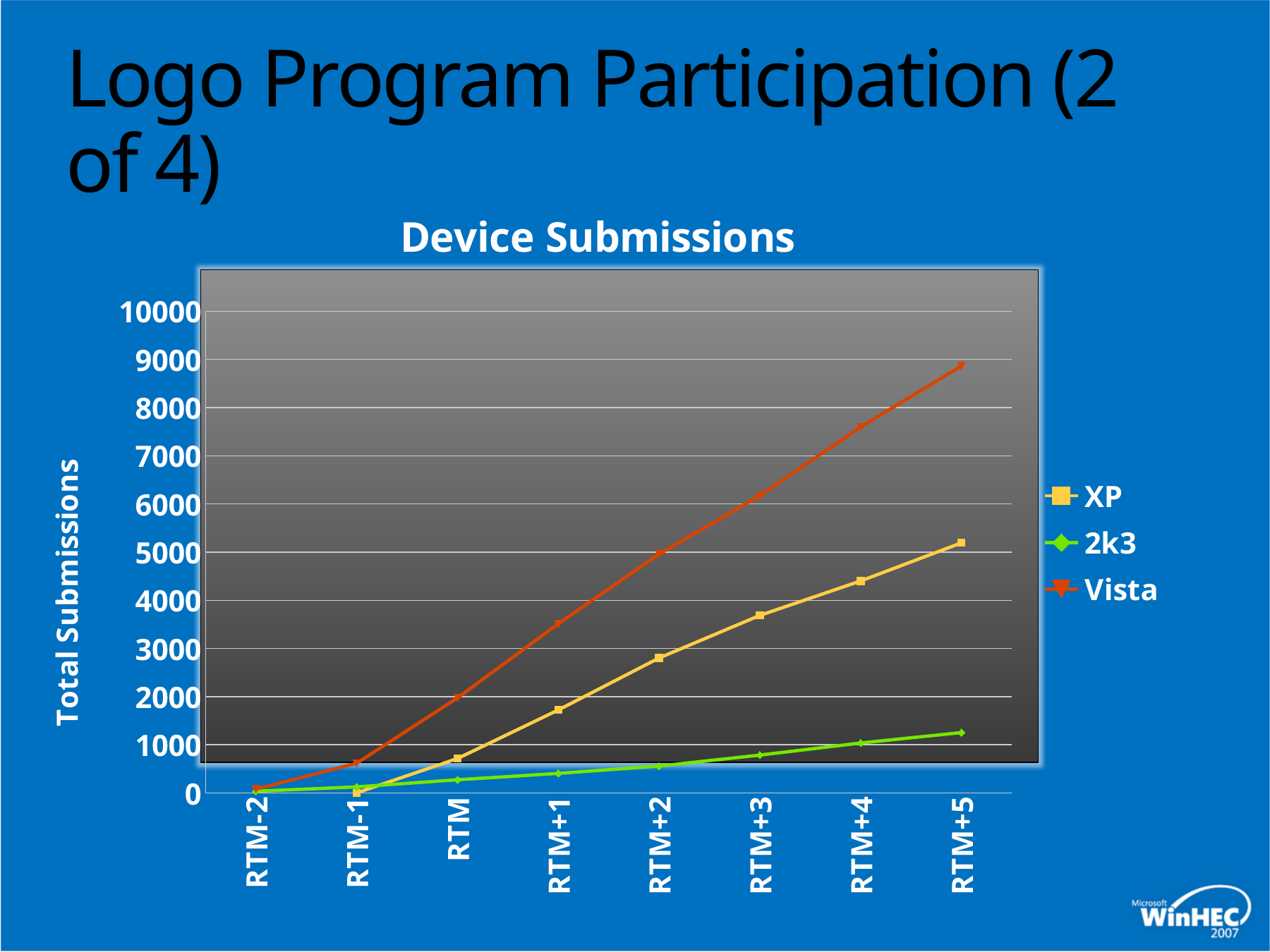
What is the title of the chart? Device Submissions At RTM+3, which series has the larger value, XP or 2k3? XP Which series has the highest value at RTM+5? Vista Which series has the lowest value at RTM+5? 2k3 Is the value for 2k3 at RTM+5 greater or less than 2000? less Is the value for XP at RTM+3 greater or less than 4000? less What kind of chart is shown on the slide? line chart How many categories are shown on the x axis? 8 Is the value for Vista at RTM+5 greater or less than 8000? greater How many series does the legend list? 3 Do the values for Vista rise or fall from RTM-2 to RTM+5? rise